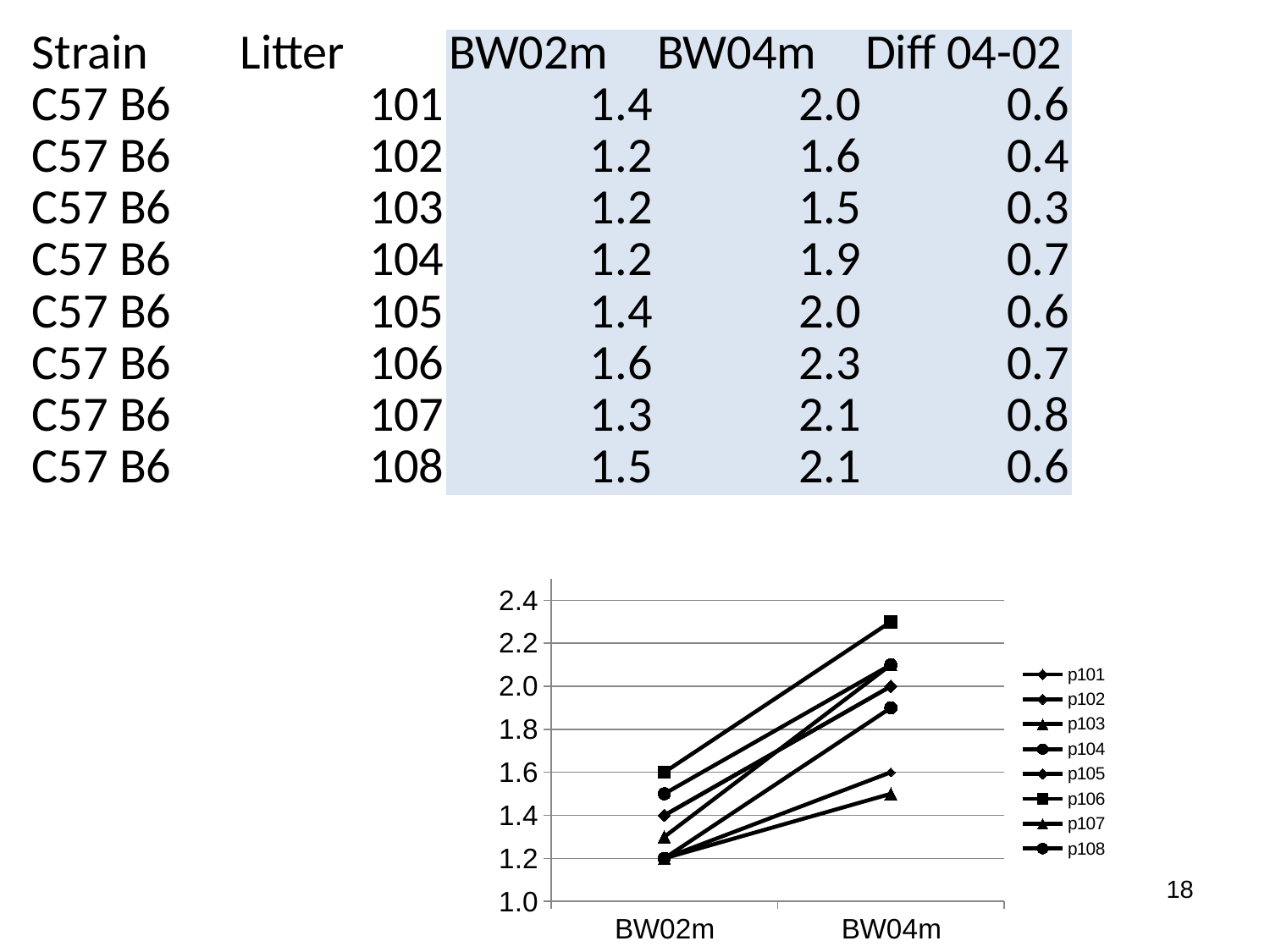
Which series has the lowest value at BW04m? p103 What is the highest value shown on the chart's y axis? 2.4 Which series has the highest value at BW04m? p106 What is the value of p106 at BW02m? 1.6 Do the series values rise or fall from BW02m to BW04m? rise What is the value of p106 at BW04m? 2.3 Is the value for p106 at BW04m greater or less than 2.2? greater What is the difference between the BW04m and BW02m values for p106? 0.7 How many series does the chart's legend list? 8 What kind of chart is shown on the slide? line chart How many categories are on the x axis of the chart? 2 At BW04m, which is larger, p106 or p103? p106